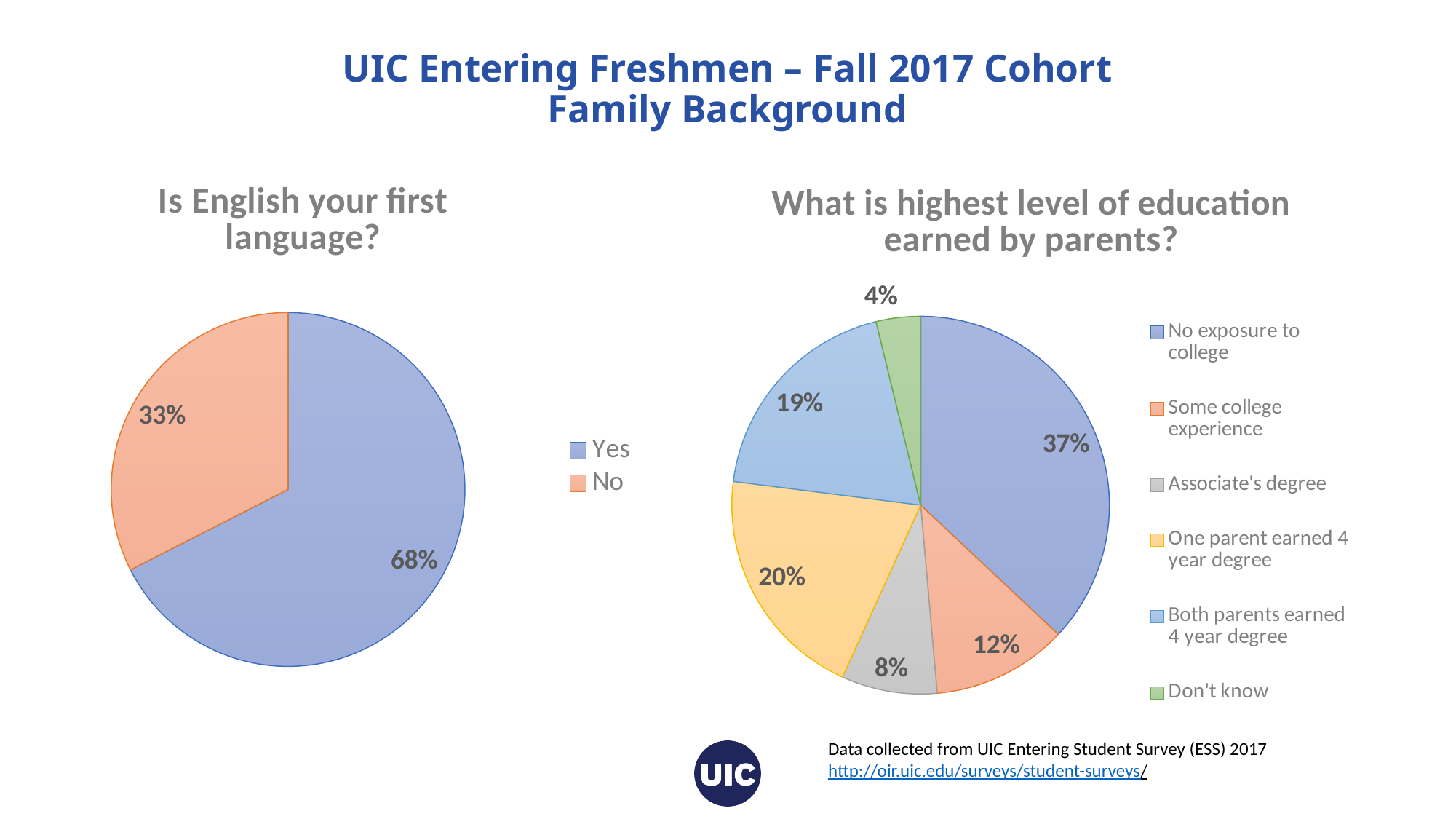
In the 'What is highest level of education earned by parents?' chart, what share is 'No exposure to college'? 37% What kind of chart is the 'Is English your first language?' chart? Pie chart In the 'Is English your first language?' chart, what share of respondents answered Yes? 68% In the 'What is highest level of education earned by parents?' chart, which is larger: 'Some college experience' or 'Associate's degree'? Some college experience In the 'What is highest level of education earned by parents?' chart, what share is 'Both parents earned 4 year degree'? 19% In the 'What is highest level of education earned by parents?' chart, which category has the largest share? No exposure to college In the 'What is highest level of education earned by parents?' chart, which category has the smallest share? Don't know How many slices does the 'Is English your first language?' pie chart have? 2 How many categories does the legend of the 'What is highest level of education earned by parents?' chart list? 6 In the 'What is highest level of education earned by parents?' chart, what is the difference between 'One parent earned 4 year degree' and 'Some college experience'? 8%